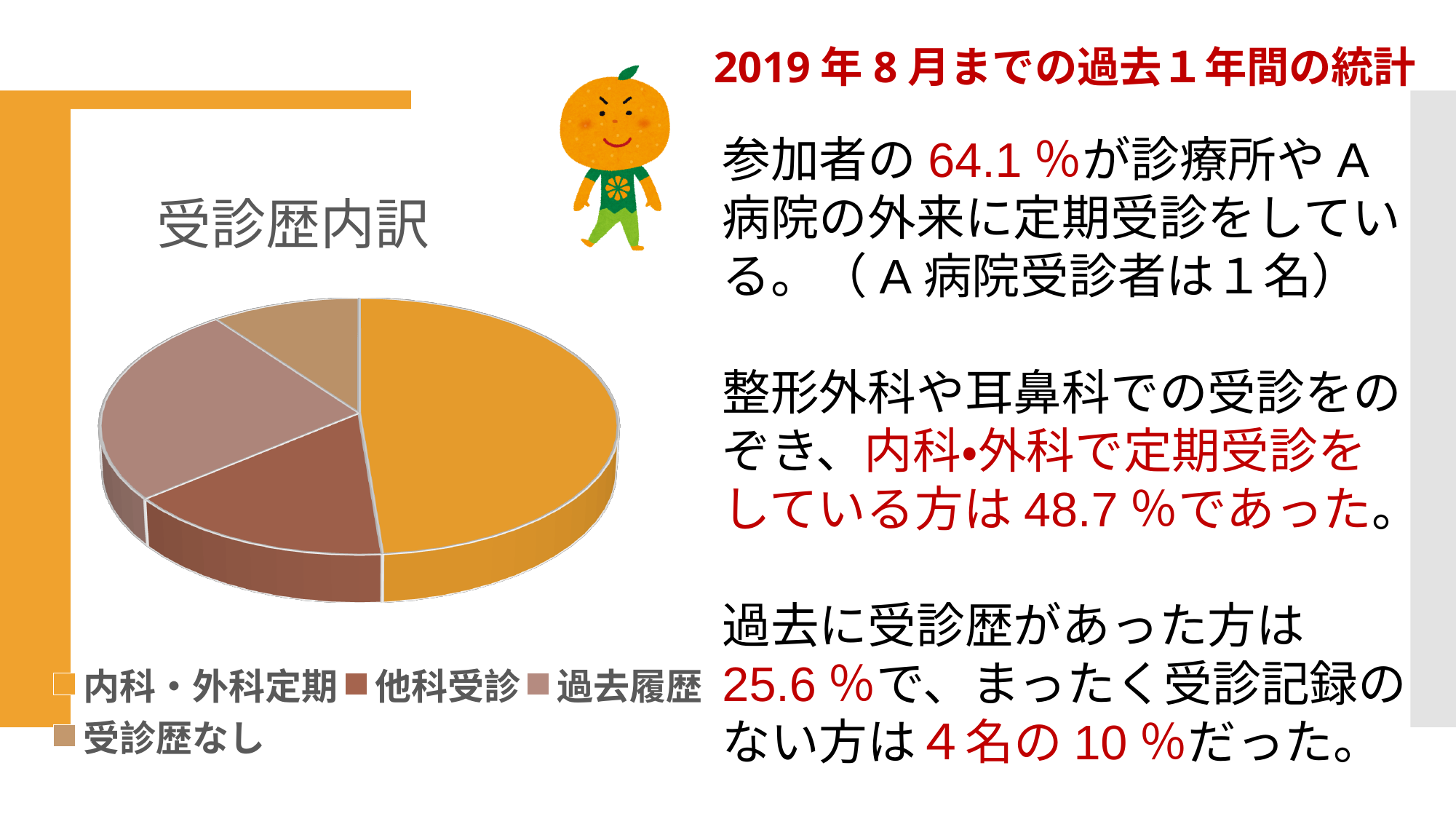
Which slice is larger, 過去履歴 or 他科受診? 過去履歴 Which slice is larger, 過去履歴 or 受診歴なし? 過去履歴 Which slice is larger, 内科・外科定期 or 他科受診? 内科・外科定期 How many entries does the legend of the pie chart list? 4 What kind of chart is shown on the slide? Pie chart Which category has the largest slice in the pie chart? 内科・外科定期 What is the title of the pie chart? 受診歴内訳 Which legend entry is shown in orange in the pie chart? 内科・外科定期 How many slices does the pie chart have? 4 Which category has the smallest slice in the pie chart? 受診歴なし